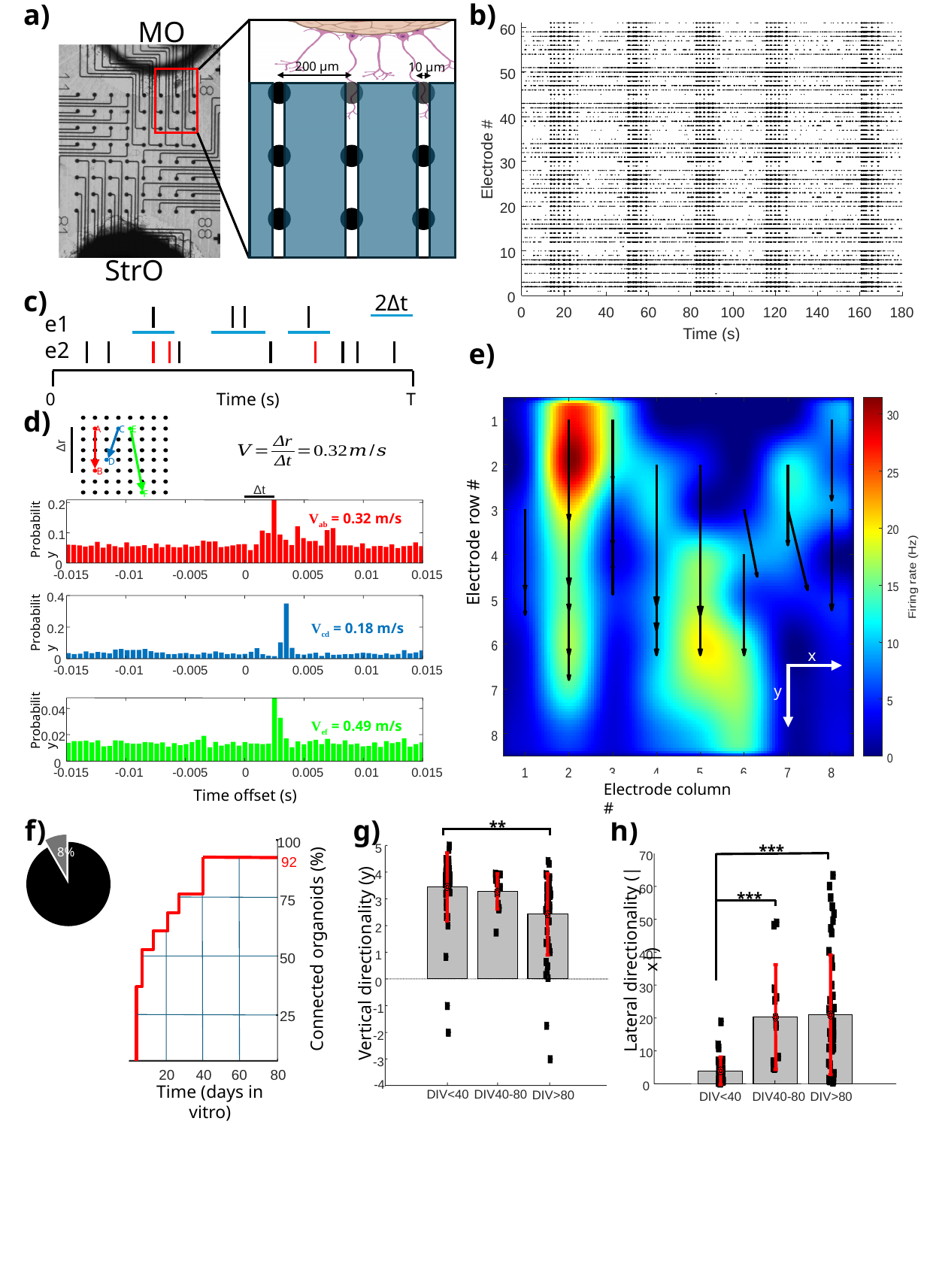
In panel d, what is the value of V_cd shown on the blue histogram? 0.18 m/s In panel f, what percentage is shown on the grey slice of the pie chart? 8% In panel d, what is the value of V_ef shown on the green histogram? 0.49 m/s In panel d, what is the difference between V_ef and V_cd? 0.31 m/s In panel h, is the bar for DIV<40 greater or less than 10? less In panel g, is the bar for DIV>80 greater or less than 3? less In panel f, what value does the red step line reach at the end, as labelled on the right axis? 92 In panel d, what is the value of V_ab shown on the red histogram? 0.32 m/s In panel h, which DIV group has the lowest bar for lateral directionality? DIV<40 In panel e, what is the maximum value shown on the firing rate colour bar? 30 In panel g, which DIV group has the lowest bar for vertical directionality? DIV>80 In panel d, which of the three labelled velocities (V_ab, V_cd, V_ef) is the largest? V_ef